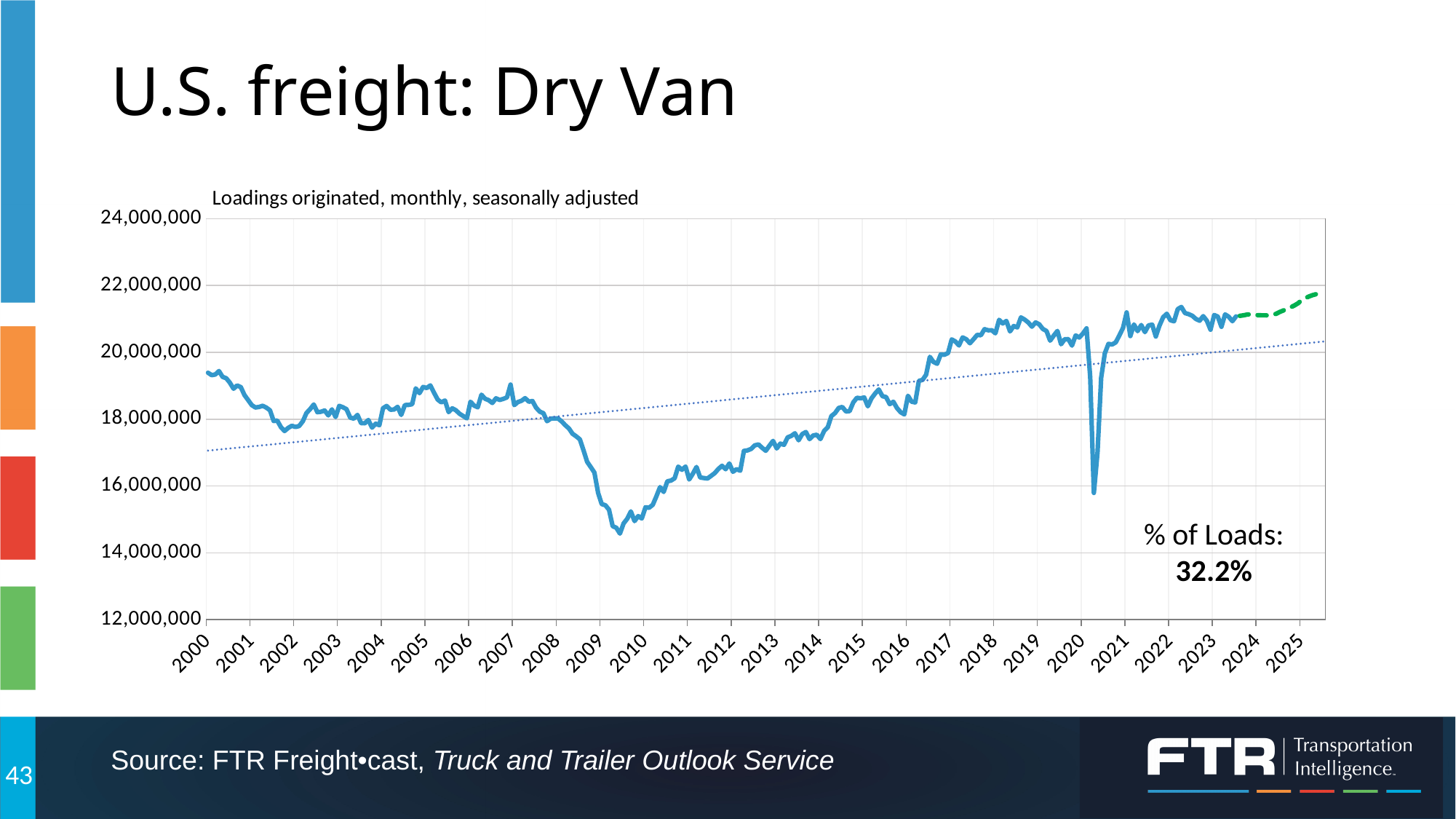
Which is larger, the value at the start of 2000 or the value in 2009? 2000 What is the '% of Loads' figure shown on the chart? 32.2% Is the value around 2012 greater or less than 18,000,000? less Is the value at the start of 2000 greater or less than 18,000,000? greater Is the lowest point of the line, around 2009, greater or less than 16,000,000? less How many year labels are shown on the x axis? 26 Do the values generally rise or fall between 2000 and 2002? fall What is the subtitle describing the data plotted in the chart? Loadings originated, monthly, seasonally adjusted Around which year does the line reach its lowest point? 2009 What kind of chart is shown on the slide? line chart Do the values generally rise or fall between 2009 and 2018? rise